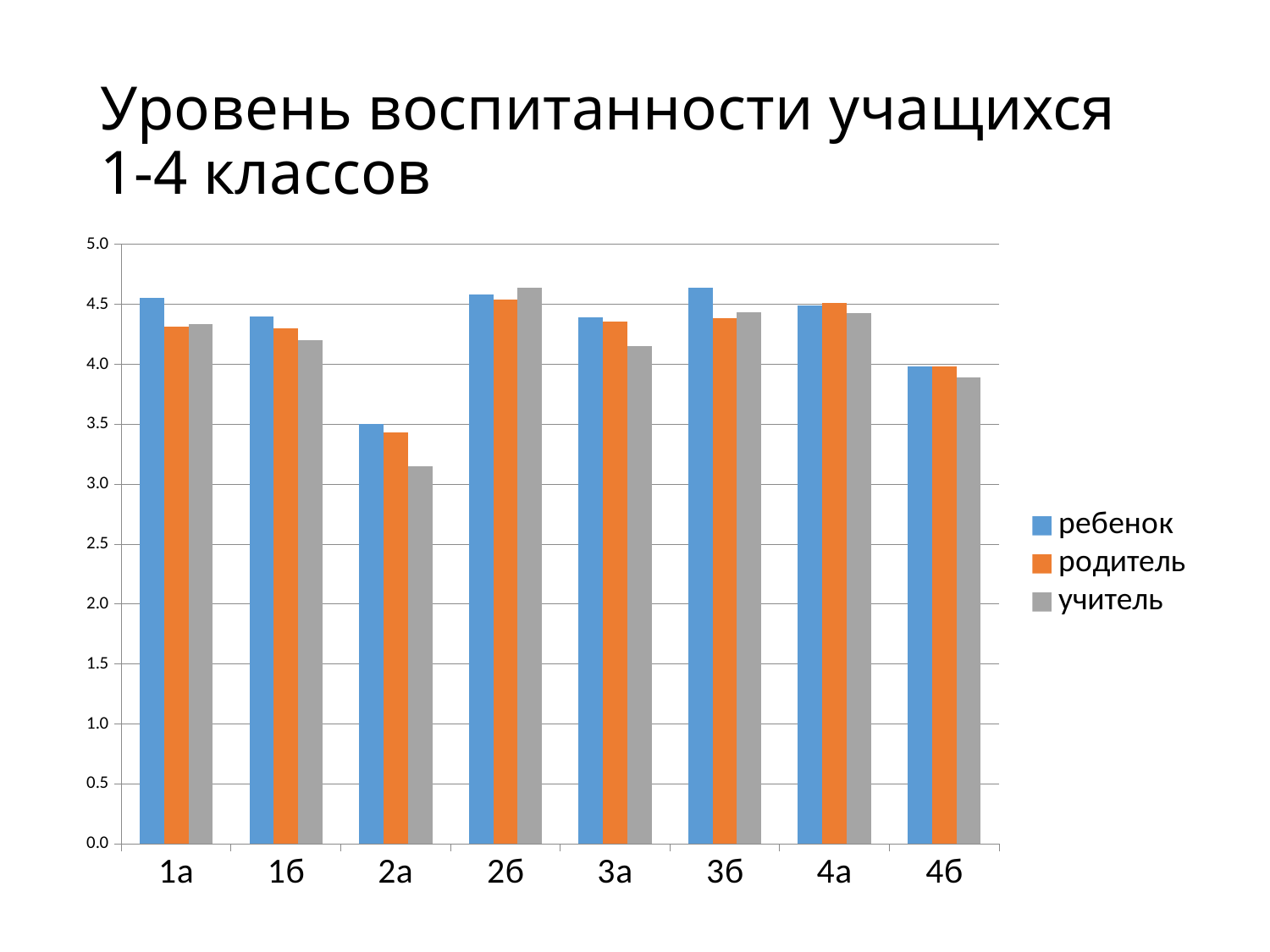
Which class has the lowest value for the учитель series? 2а What is the title of the chart on the slide? Уровень воспитанности учащихся 1-4 классов Which class has the lowest value for the ребенок series? 2а For class 3б, which is larger: the ребенок value or the родитель value? ребенок What kind of chart is shown on the slide? bar chart Is the учитель value for 2а greater or less than 3.5? less For class 2а, which is larger: the ребенок value or the учитель value? ребенок Which class has the highest value for the учитель series? 2б How many series does the legend list? 3 How many classes (categories) are shown on the x axis? 8 Is the учитель value for 1б greater or less than 4.0? greater Is the учитель value for 3а greater or less than 4.5? less